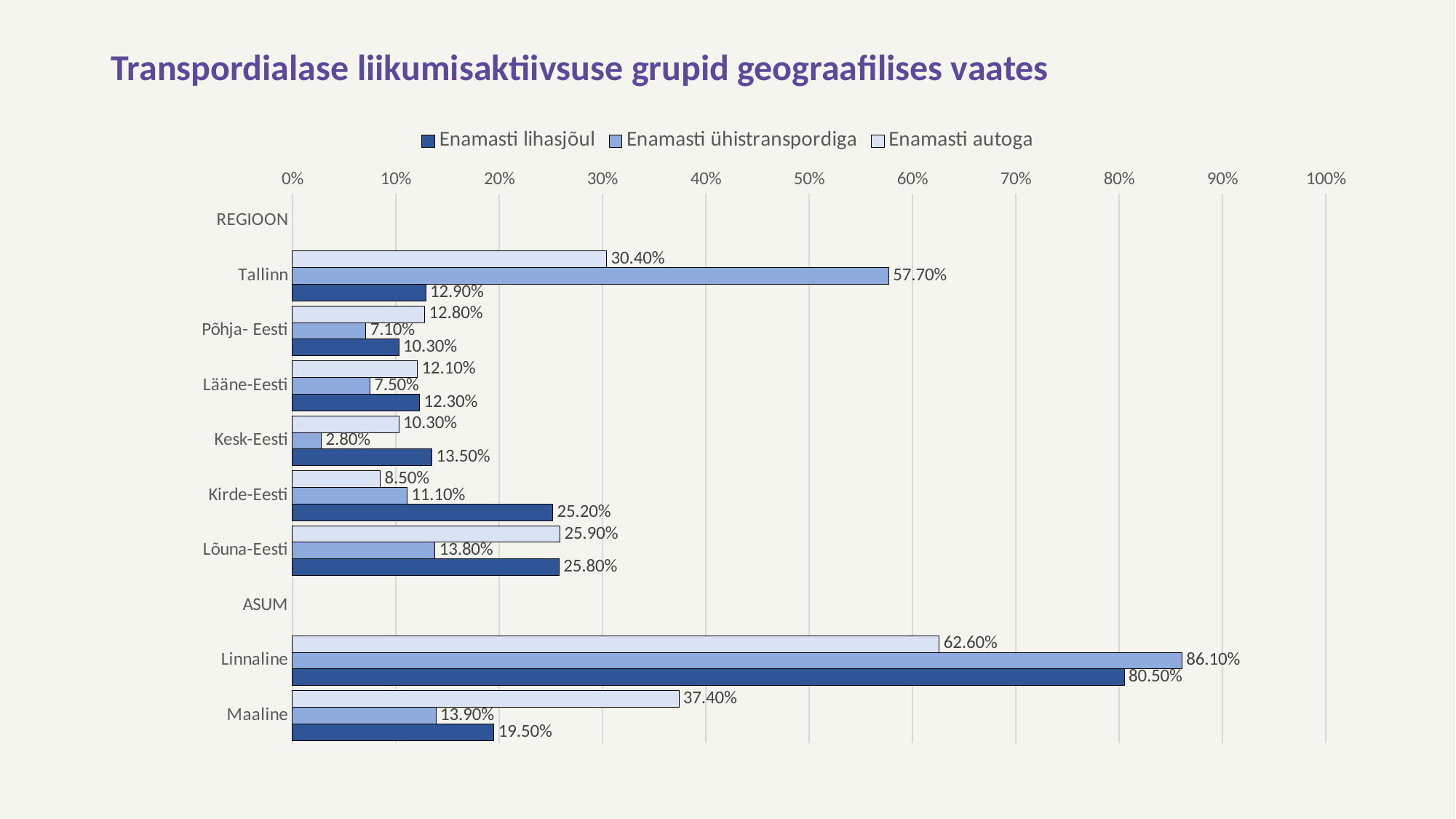
Is the Enamasti autoga value for Linnaline greater or less than 60%? greater Which is larger for Kirde-Eesti: the Enamasti lihasjõul value or the Enamasti autoga value? Enamasti lihasjõul Which category has the highest value in the Enamasti ühistranspordiga series? Linnaline What is the title of the chart? Transpordialase liikumisaktiivsuse grupid geograafilises vaates What is the difference between the Enamasti ühistranspordiga and Enamasti lihasjõul values for Linnaline? 5.60% Which category has the lowest value in the Enamasti ühistranspordiga series? Kesk-Eesti What kind of chart is shown on the slide? Bar chart How many categories have bars plotted in the chart? 8 What is the value for Tallinn in the Enamasti ühistranspordiga series? 57.70% What is the value for Kesk-Eesti in the Enamasti lihasjõul series? 13.50% What is the value for Maaline in the Enamasti autoga series? 37.40% How many series does the legend list? 3